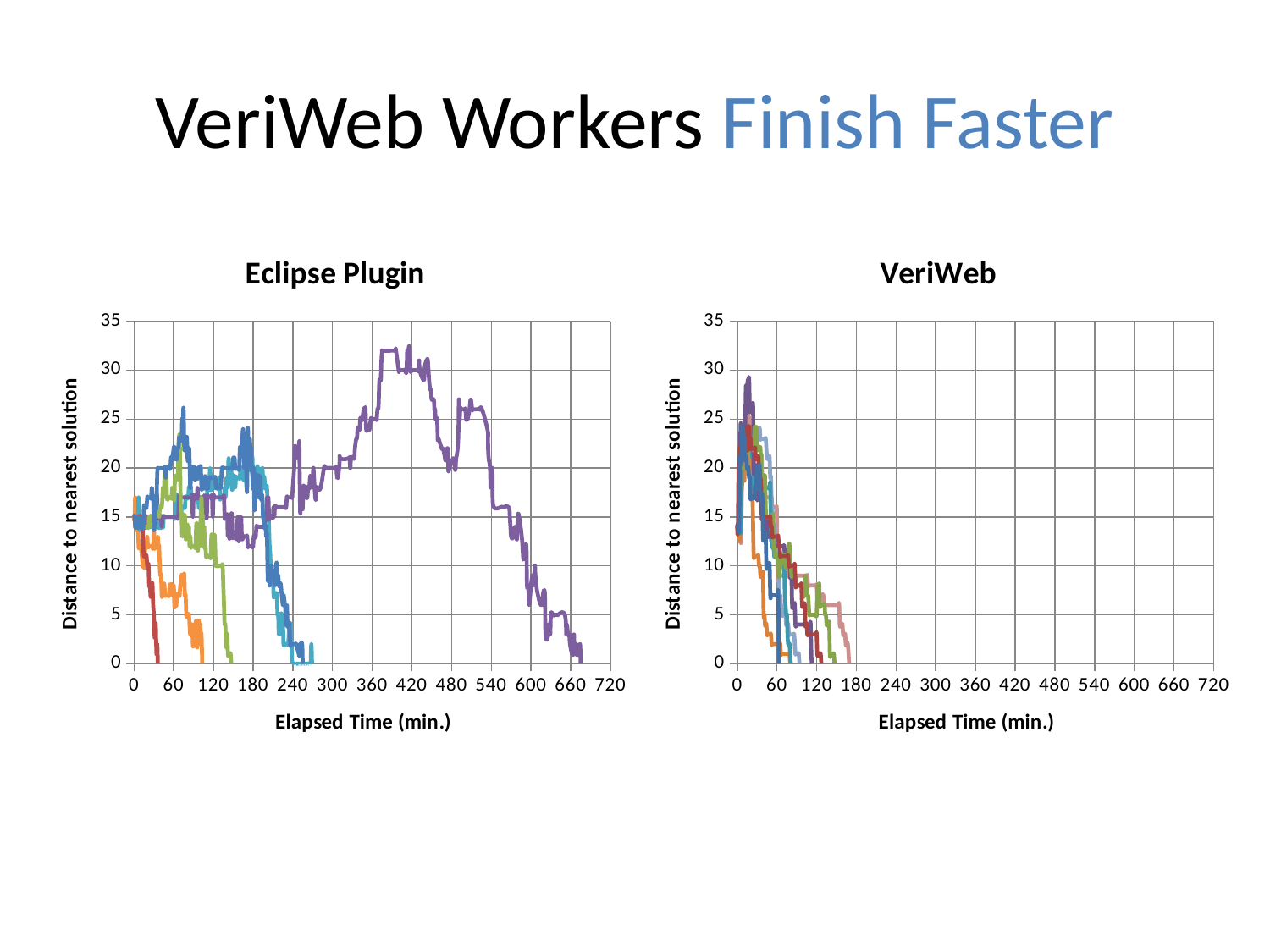
What is the y-axis label on the VeriWeb chart? Distance to nearest solution In the Eclipse Plugin chart, are the values of the lines at elapsed time 0 greater or less than 10? greater In the VeriWeb chart, do the lines generally rise or fall as elapsed time increases? fall In the Eclipse Plugin chart, is the latest elapsed time at which a line reaches 0 greater or less than 600? greater In the Eclipse Plugin chart, is the highest value reached by the purple line greater or less than 30? greater What is the highest tick shown on the x axis of the Eclipse Plugin chart? 720 What kind of chart is the VeriWeb chart? line chart What kind of chart is the Eclipse Plugin chart? line chart Which chart has lines that extend to a later elapsed time, Eclipse Plugin or VeriWeb? Eclipse Plugin